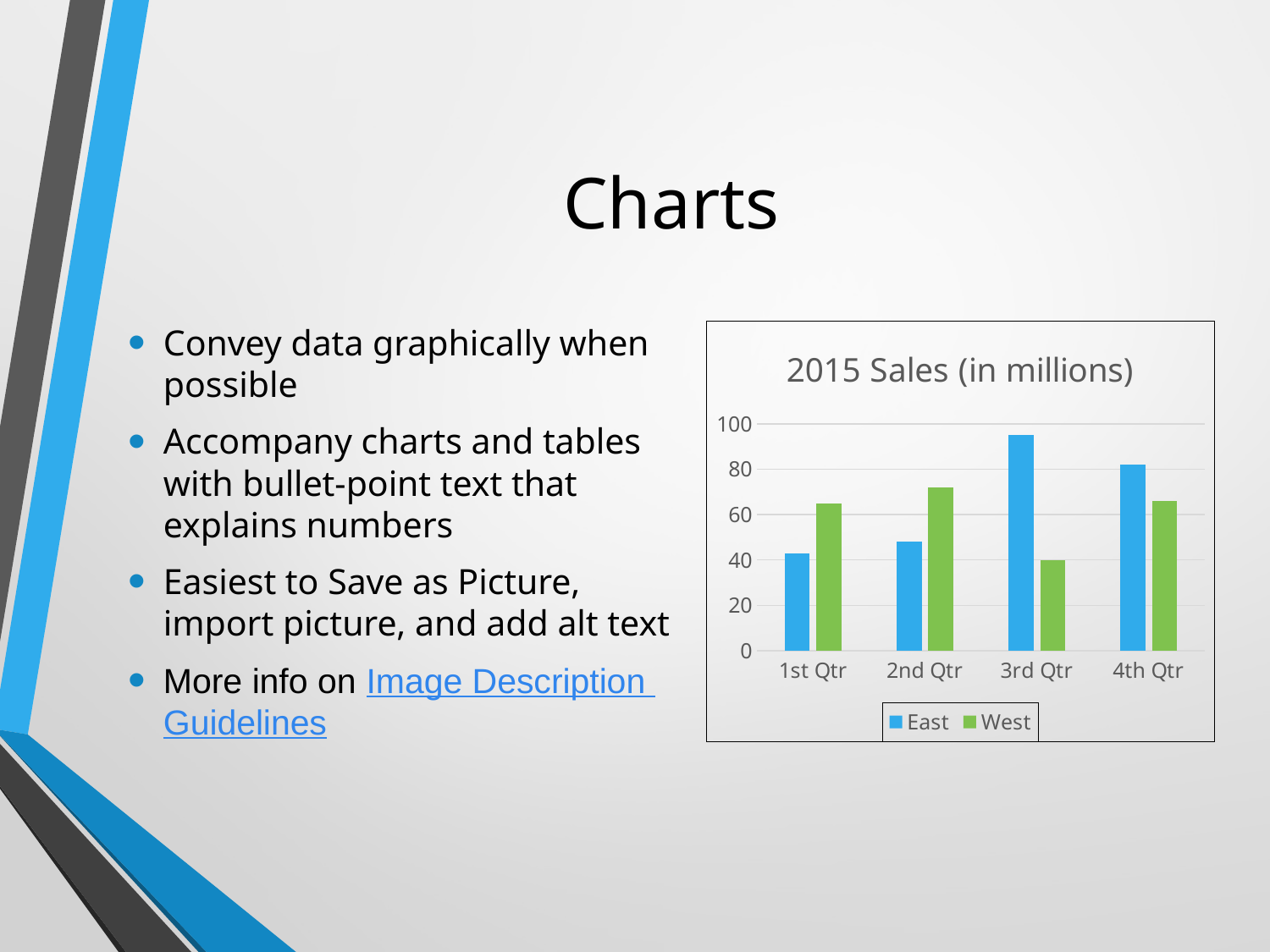
Is the East value for the 3rd Qtr greater or less than 80? greater Is the West value for the 3rd Qtr greater or less than 60? less How many series does the chart's legend list? 2 How many quarters are shown on the x axis of the chart? 4 What is the title of the chart? 2015 Sales (in millions) In the 1st Qtr, which series has the larger value, East or West? West Which series is shown in green in the chart? West What kind of chart is shown on the slide? bar chart In which quarter is the West value lowest? 3rd Qtr Is the East value for the 1st Qtr greater or less than 60? less In which quarter is the East value highest? 3rd Qtr In the 3rd Qtr, which series has the larger value, East or West? East